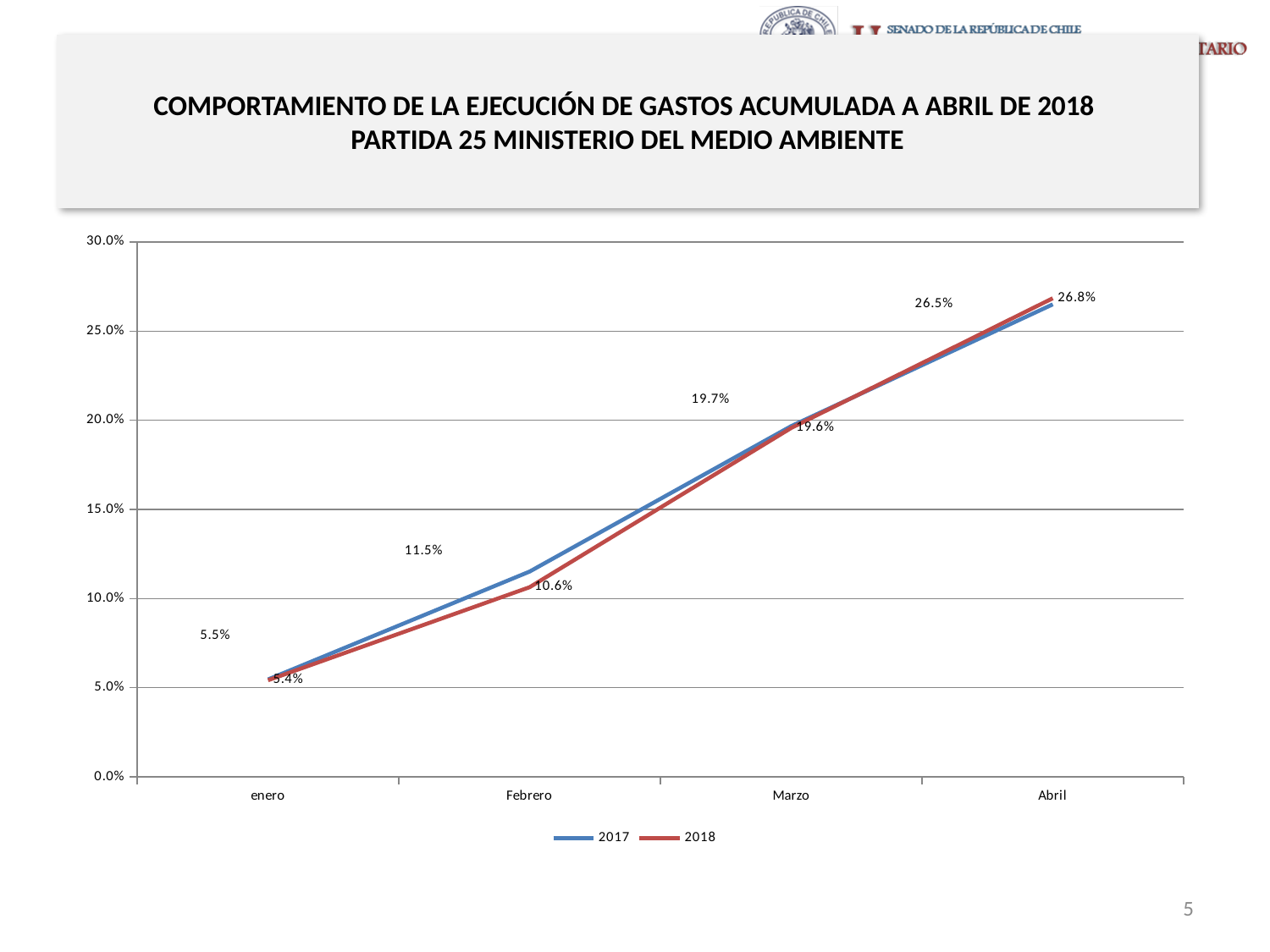
What is the value for 2017 in Marzo? 19.7% What type of chart is shown on the slide? line chart What is the value for 2017 in Febrero? 11.5% Do the 2018 values rise or fall from enero to Abril? rise How many series does the legend list? 2 What is the value for 2018 in Abril? 26.8% In which month is the 2017 value lowest? enero How many months are shown on the x axis? 4 Which colour represents the 2018 series in the legend? red What is the difference between the 2017 and 2018 values in Febrero? 0.9% In which month is the 2018 value highest? Abril What is the value for 2018 in Febrero? 10.6%